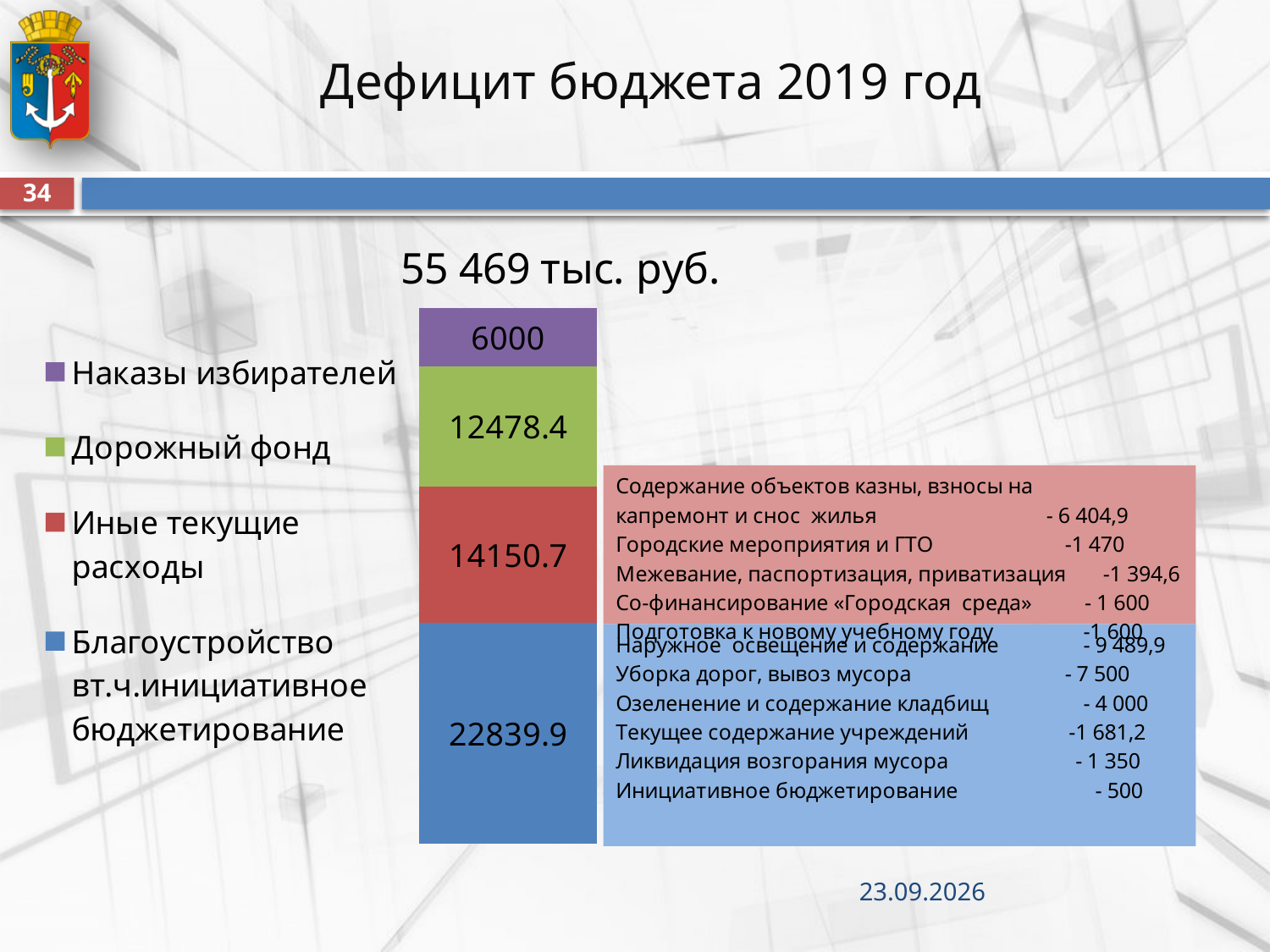
What is the value of the Наказы избирателей segment in the stacked bar? 6000 Which segment of the stacked bar has the largest value? Благоустройство вт.ч.инициативное бюджетирование How many series does the legend list? 4 What is the value of the Дорожный фонд segment in the stacked bar? 12478.4 What is the difference between the Дорожный фонд segment and the Наказы избирателей segment? 6478.4 Which segment of the stacked bar has the smallest value? Наказы избирателей What is the total of all segments in the stacked bar? 55469 What is the value of the Благоустройство вт.ч.инициативное бюджетирование segment in the stacked bar? 22839.9 What is the value of the Иные текущие расходы segment in the stacked bar? 14150.7 Which is larger: the Иные текущие расходы segment or the Дорожный фонд segment? Иные текущие расходы What kind of chart is shown on the slide? Stacked bar chart What is the difference between the Благоустройство вт.ч.инициативное бюджетирование segment and the Иные текущие расходы segment? 8689.2